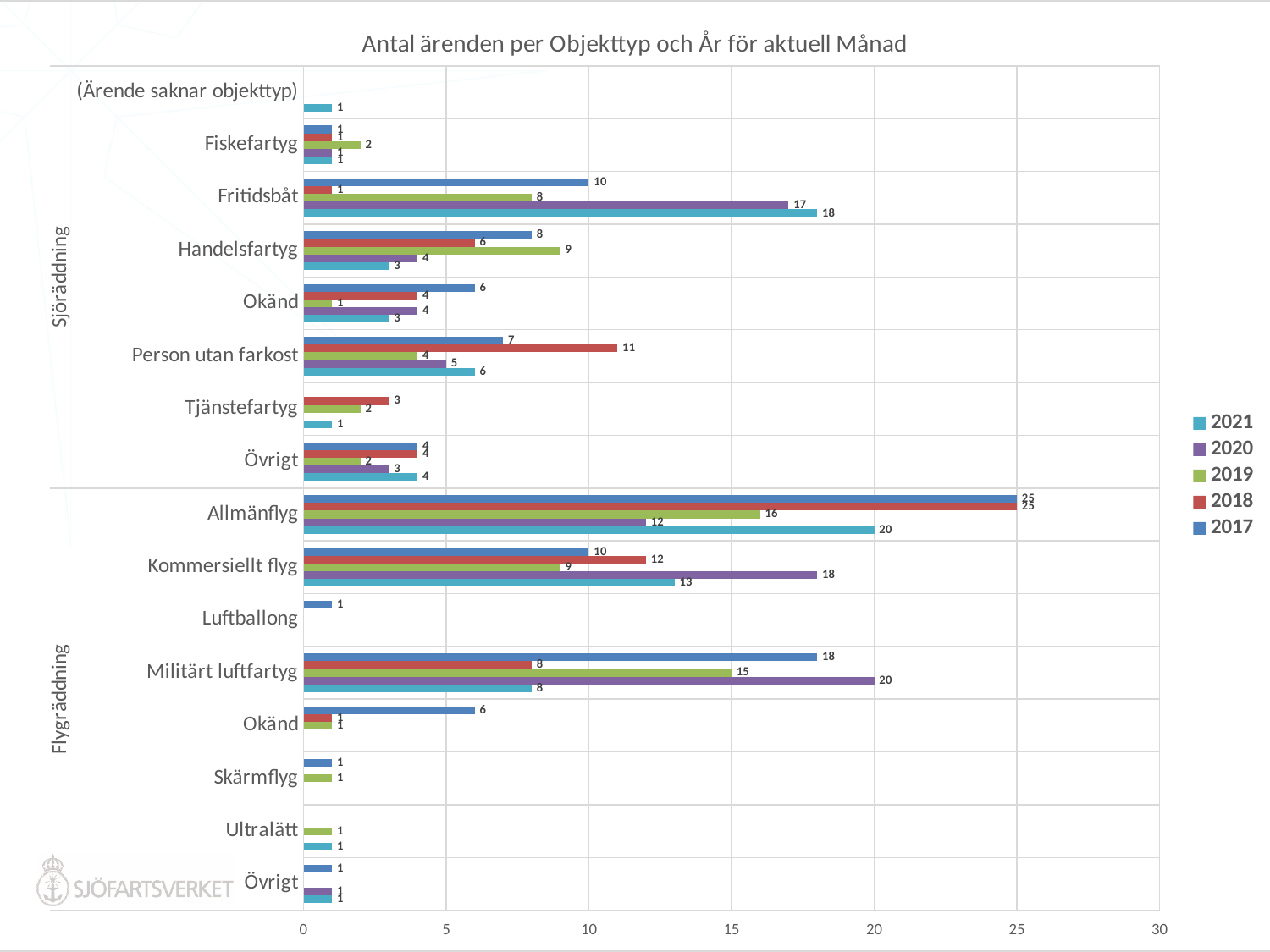
How many series does the legend list? 5 Which year has the lowest value for Fritidsbåt? 2018 What kind of chart is shown on the slide? bar chart What is the title of the chart? Antal ärenden per Objekttyp och År för aktuell Månad Which is larger for Handelsfartyg: the 2019 value or the 2017 value? 2019 What is the value for Militärt luftfartyg in 2020? 20 Which year has the highest value for Kommersiellt flyg? 2020 What is the value for Fritidsbåt in 2021? 18 What is the value for Okänd under Flygräddning in 2017? 6 What is the difference between the 2021 and 2020 values for Allmänflyg? 8 Is the 2017 value for Allmänflyg greater or less than 20? greater What is the value for Person utan farkost in 2018? 11